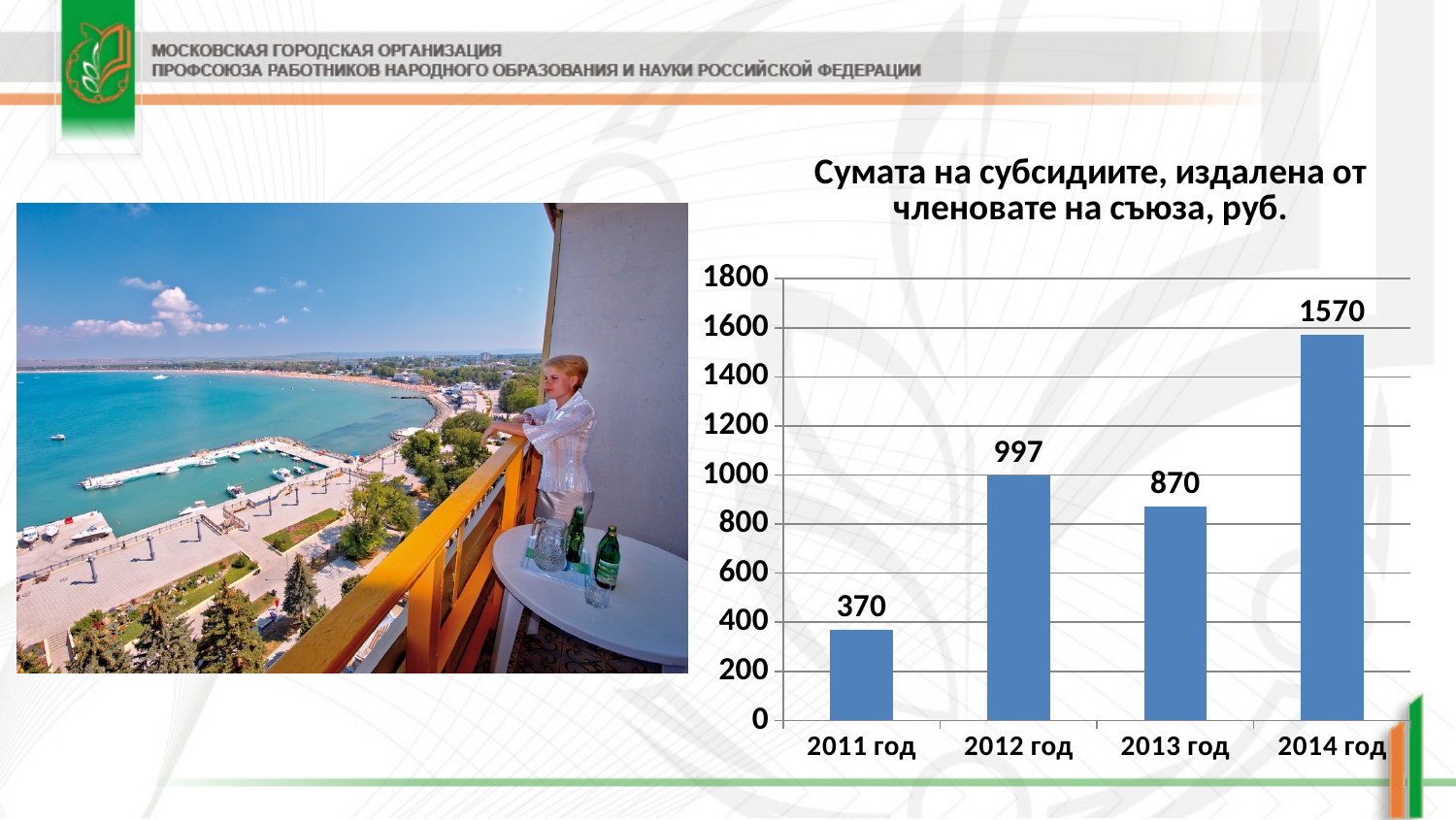
What is the value for 2014 год? 1570 What is the value for 2013 год? 870 Which is larger, the value for 2012 год or 2013 год? 2012 год What is the title of the chart? Сумата на субсидиите, издалена от членовате на съюза, руб. Which year has the lowest value? 2011 год What is the difference between the values for 2014 год and 2013 год? 700 Which year has the highest value? 2014 год Is the value for 2014 год greater or less than 1400? greater What kind of chart is shown? bar chart What is the value for 2012 год? 997 What is the value for 2011 год? 370 How many years are shown on the chart? 4